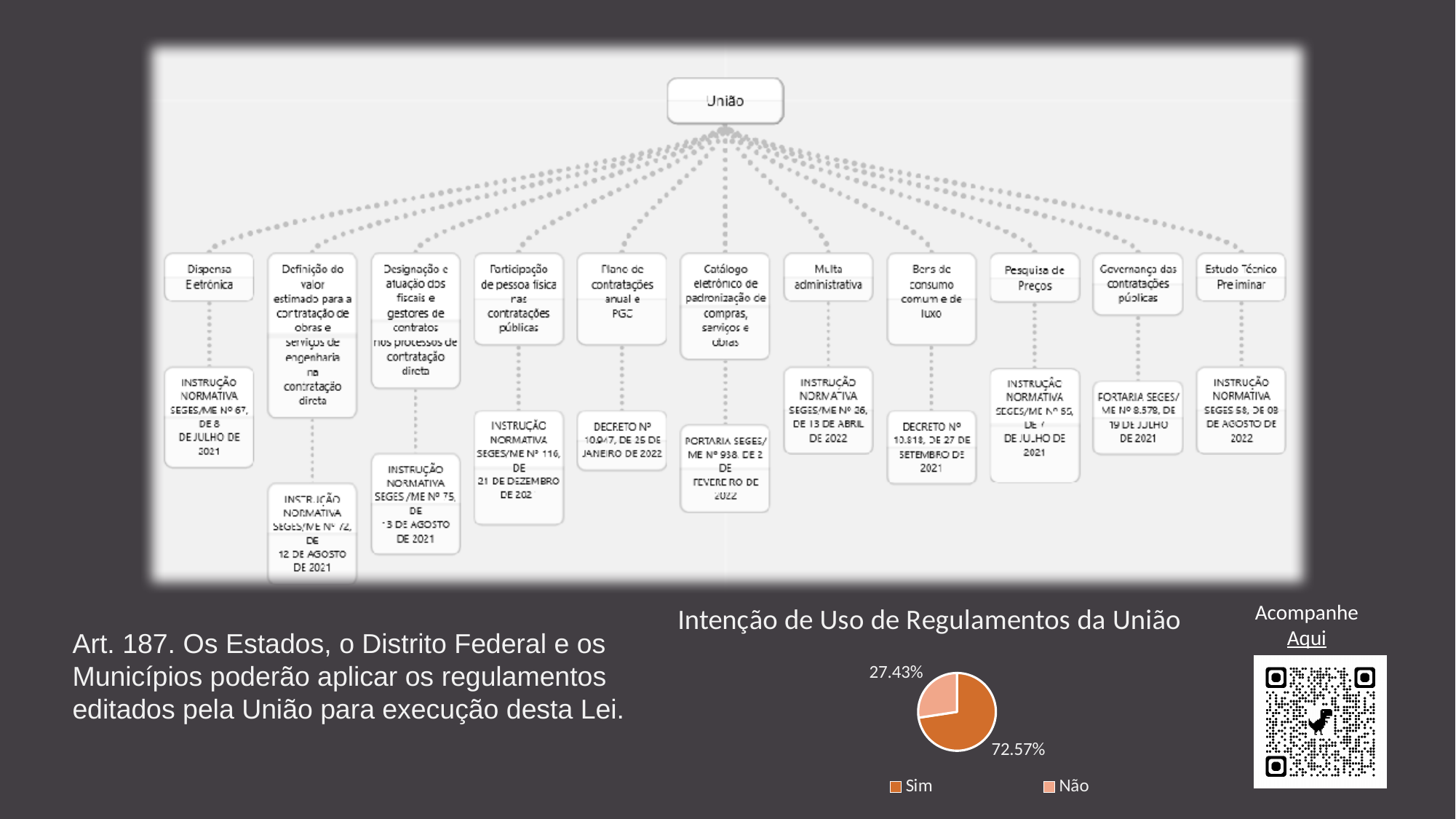
What is the difference between the 'Sim' and 'Não' values in the pie chart? 45.14% What is the title of the pie chart on the slide? Intenção de Uso de Regulamentos da União Which slice of the pie chart is the largest? Sim In the pie chart, which is larger: 'Sim' or 'Não'? Sim What kind of chart is shown under the title 'Intenção de Uso de Regulamentos da União'? pie chart In the pie chart, what is the value for 'Sim'? 72.57% What colour is the 'Sim' slice in the pie chart? dark orange Which slice of the pie chart is the smallest? Não How many slices does the pie chart have? 2 How many entries does the legend of the pie chart list? 2 In the pie chart, what is the value for 'Não'? 27.43%